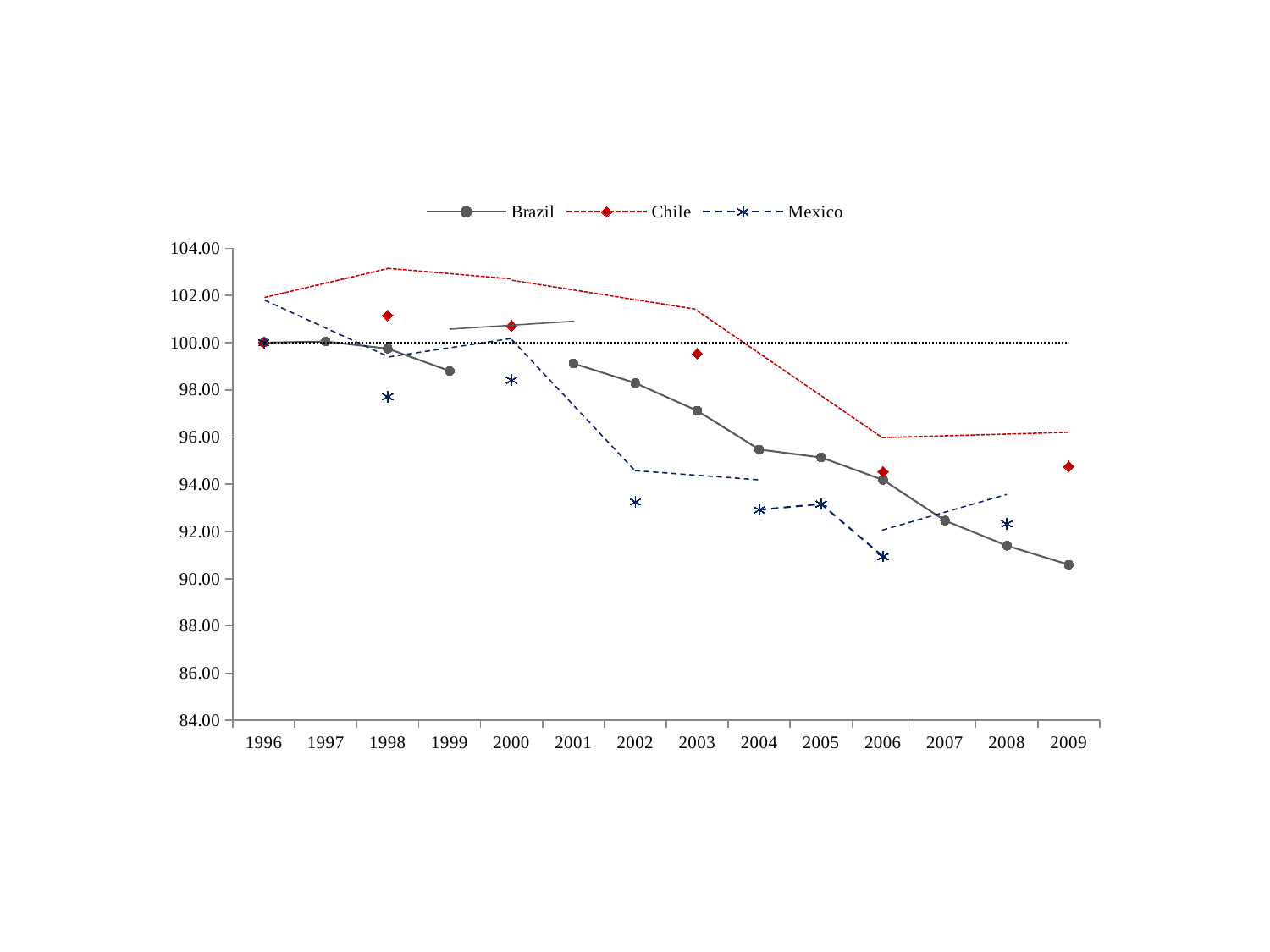
In 2009, which is larger, the value for Chile or the value for Brazil? Chile Does the Brazil series rise or fall from 1996 to 2009? fall Is the value for Brazil in 2002 greater or less than 100.00? less Which countries are listed in the legend? Brazil, Chile, Mexico How many series does the legend list? 3 How many years are shown along the x axis? 14 Is the value for Chile in 1998 greater or less than 100.00? greater Is the value for Brazil in 2009 greater or less than 92.00? less What kind of chart is shown on the slide? line chart Which series has the highest value in 2009? Chile